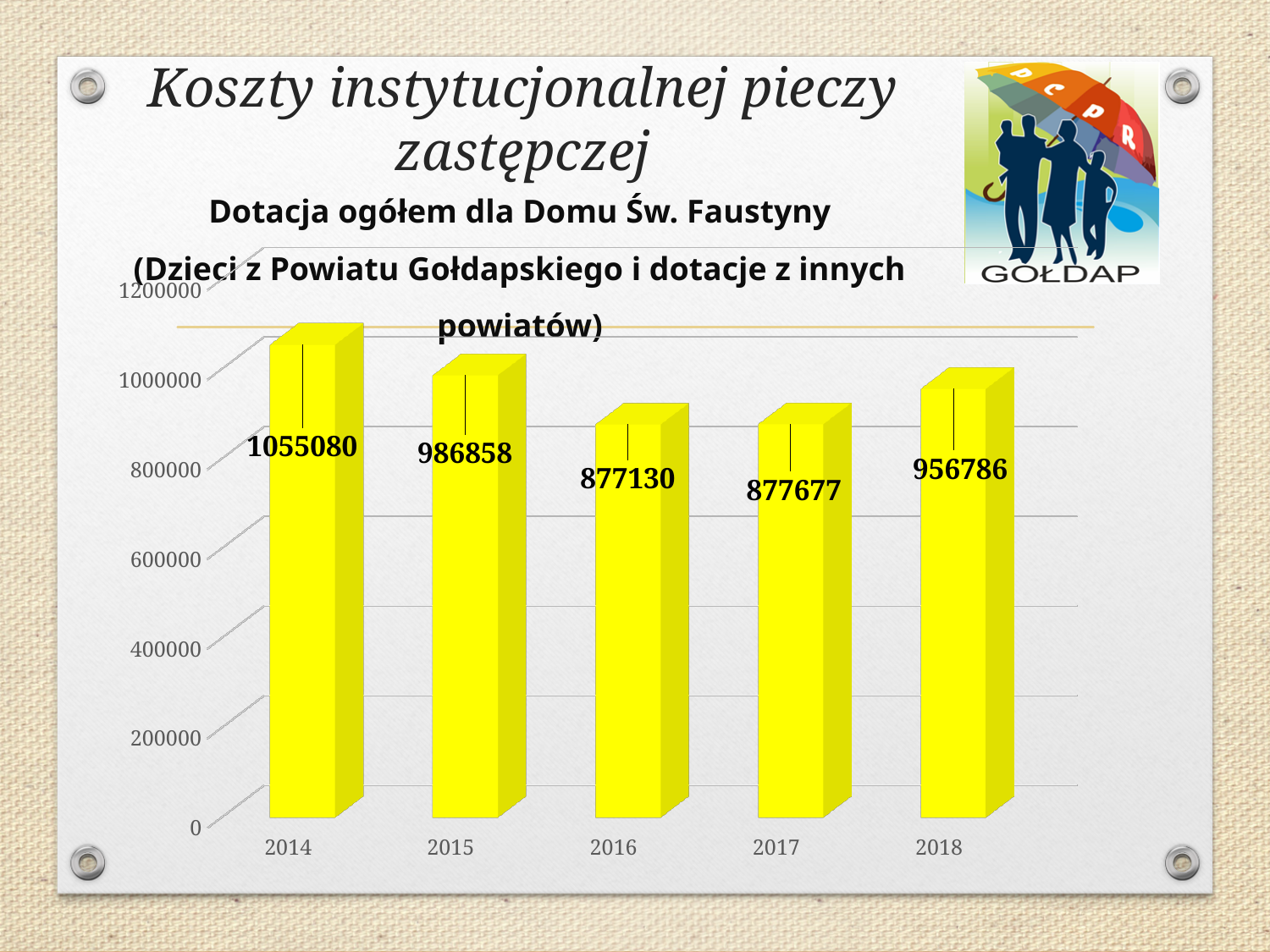
Which year has the highest value? 2014 What is the difference between the values for 2018 and 2017? 79109 Which is larger, the value for 2015 or the value for 2018? 2015 What is the difference between the values for 2014 and 2015? 68222 Do the values rise or fall from 2014 to 2016? fall What kind of chart is shown on the slide? bar chart How many years are shown on the x axis? 5 What is the value for 2018? 956786 Is the value for 2017 greater or less than 800000? greater What is the value for 2014? 1055080 What is the value for 2016? 877130 Which year has the lowest value? 2016